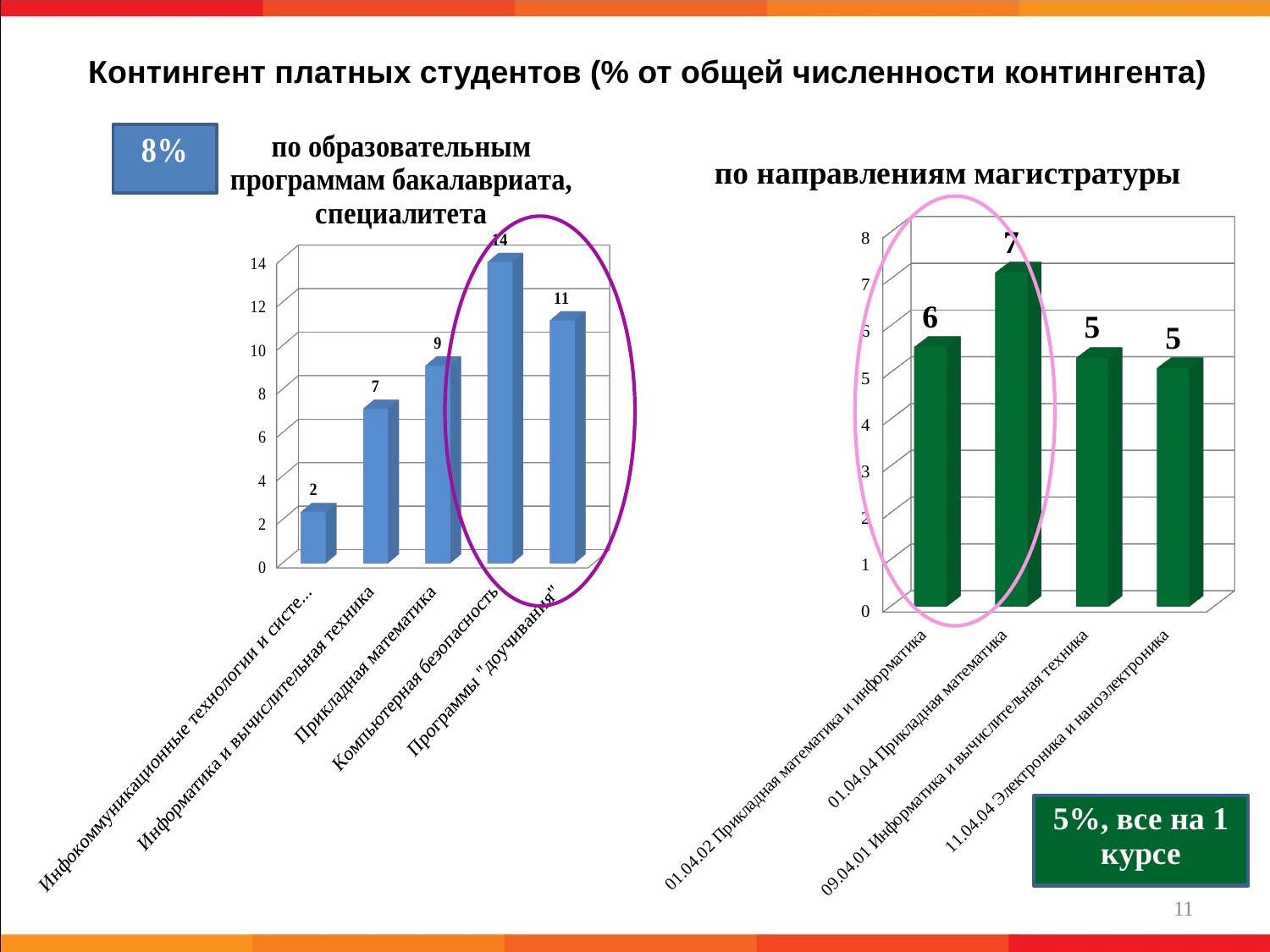
In the right chart (по направлениям магистратуры), which category has the highest value? 01.04.04 Прикладная математика What type of chart is the right chart (по направлениям магистратуры)? Bar chart In the left chart (по образовательным программам бакалавриата, специалитета), what is the value for Прикладная математика? 9 In the left chart (по образовательным программам бакалавриата, специалитета), how many categories are plotted? 5 In the left chart (по образовательным программам бакалавриата, специалитета), which category has the highest value? Компьютерная безопасность In the right chart (по направлениям магистратуры), how many categories are plotted? 4 In the right chart (по направлениям магистратуры), what is the value for 11.04.04 Электроника и наноэлектроника? 5 In the right chart (по направлениям магистратуры), which is larger: 01.04.02 Прикладная математика и информатика or 09.04.01 Информатика и вычислительная техника? 01.04.02 Прикладная математика и информатика In the left chart (по образовательным программам бакалавриата, специалитета), what is the difference between Компьютерная безопасность and Программы "доучивания"? 3 In the left chart (по образовательным программам бакалавриата, специалитета), which category has the lowest value? Инфокоммуникационные технологии и систе... In the right chart (по направлениям магистратуры), what is the value for 01.04.04 Прикладная математика? 7 In the left chart (по образовательным программам бакалавриата, специалитета), what is the value for Компьютерная безопасность? 14